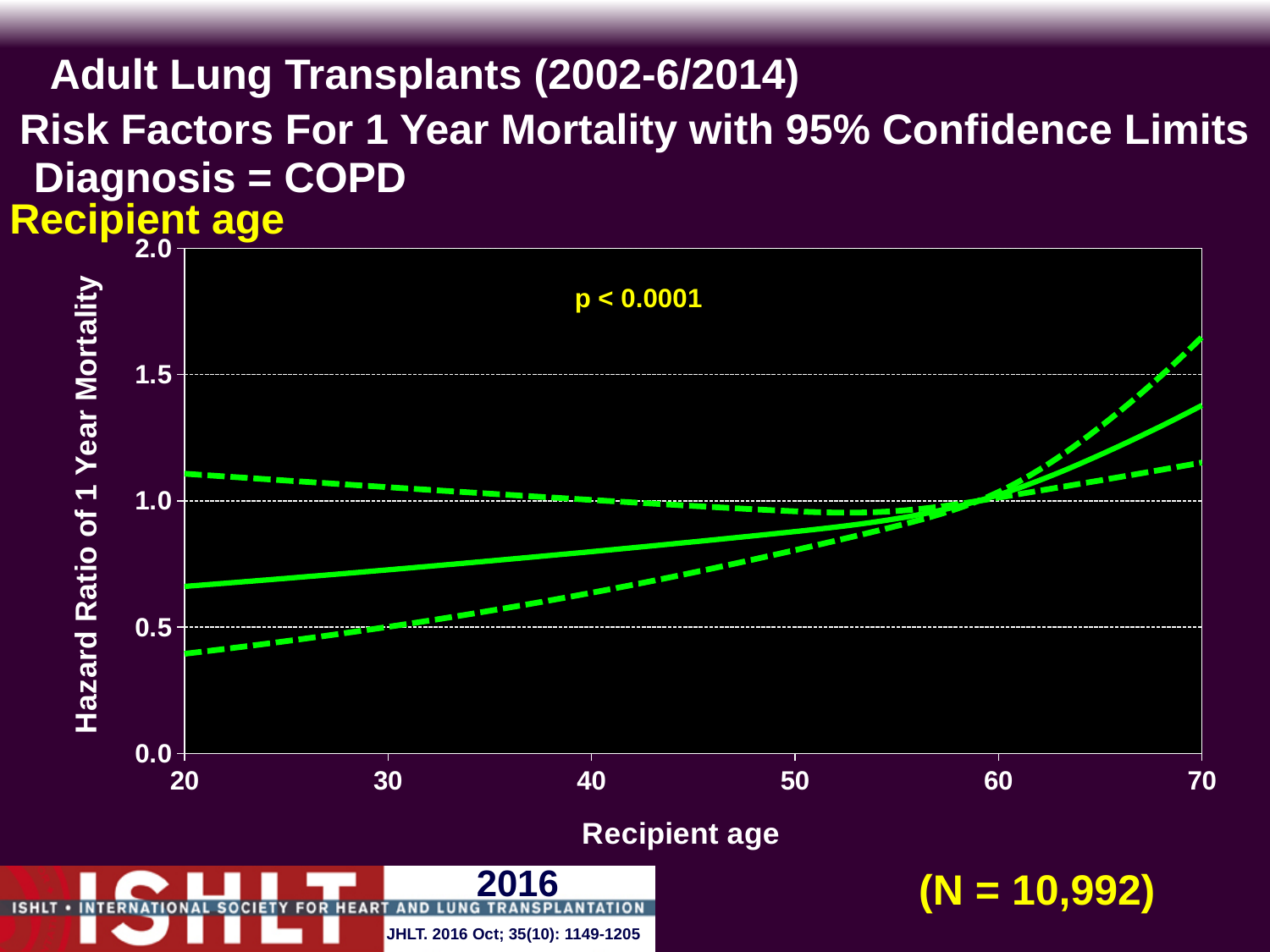
Is the upper dashed confidence limit at recipient age 20 greater or less than 1.0? greater Does the solid hazard ratio line rise or fall as recipient age increases from 20 to 70? rise Is the upper dashed confidence limit at recipient age 70 greater or less than 1.5? greater What kind of chart is shown on the slide? line chart Is the hazard ratio on the solid line at recipient age 70 greater or less than 1.0? greater What is the sample size (N) shown on the slide? N = 10,992 How many lines are plotted on the chart? 3 What p-value is printed on the chart? p < 0.0001